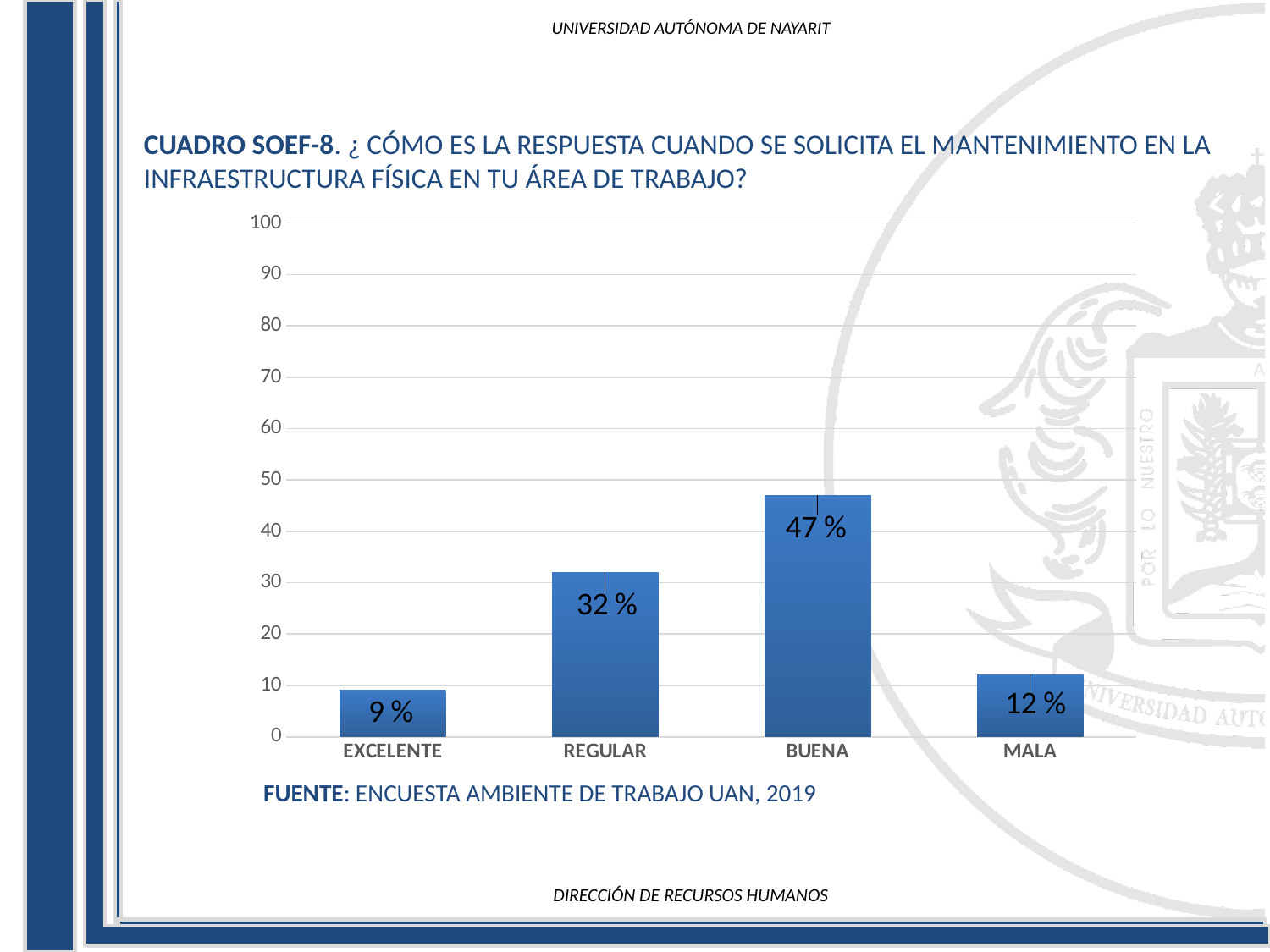
What kind of chart is shown on the slide? bar chart Which category has the highest value? BUENA What source is cited below the chart? ENCUESTA AMBIENTE DE TRABAJO UAN, 2019 What is the value for BUENA? 47 % What is the difference between the values for BUENA and REGULAR? 15 % Which category has the lowest value? EXCELENTE What is the value for EXCELENTE? 9 % What is the value for MALA? 12 % How many categories are shown on the x axis? 4 What is the value for REGULAR? 32 % Which is larger, the value for MALA or the value for EXCELENTE? MALA Is the value for REGULAR greater or less than 40? less